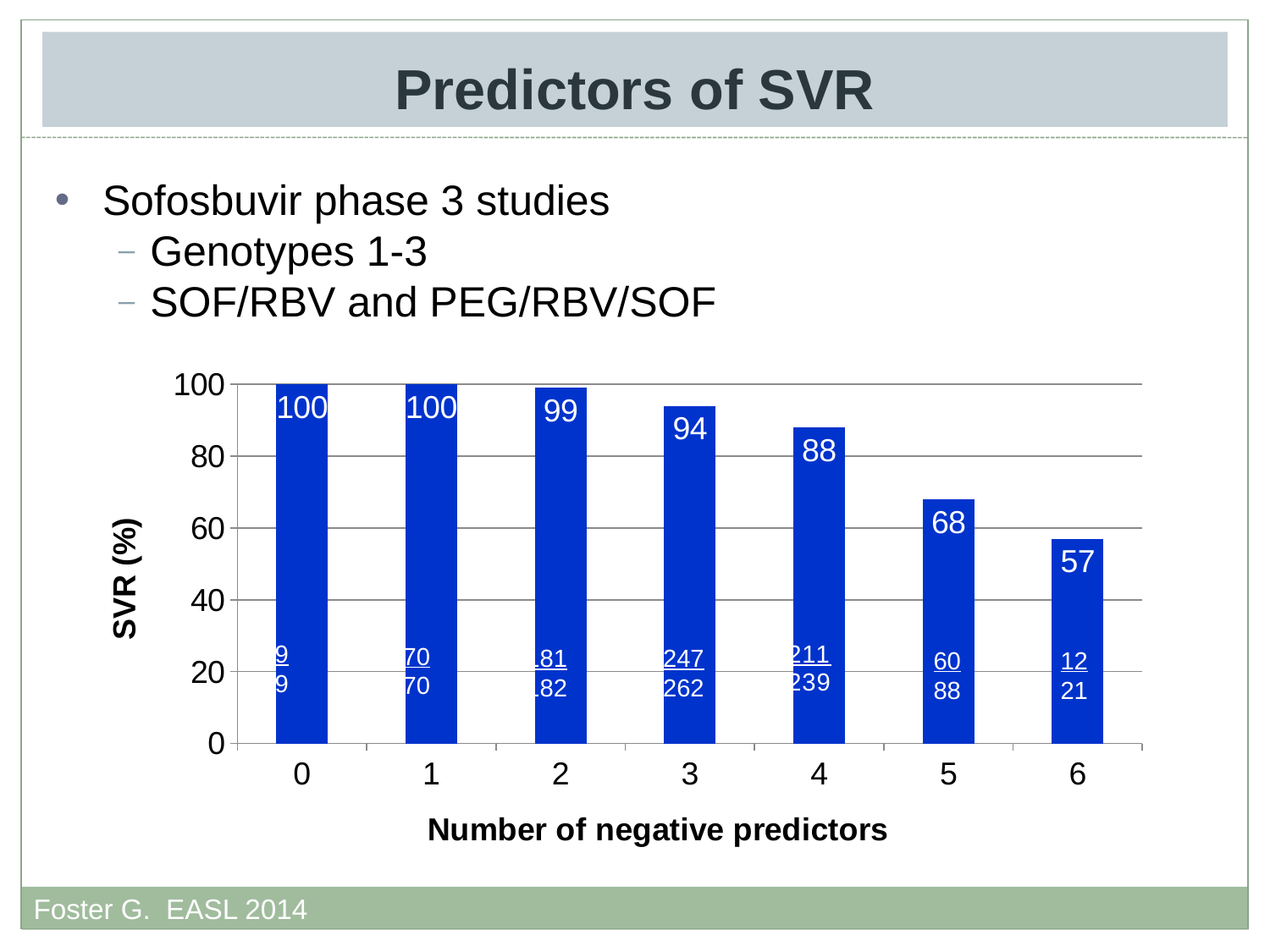
What kind of chart is shown on the slide? Bar chart What is the SVR (%) for 5 negative predictors? 68 Which number of negative predictors has the lowest SVR (%)? 6 What is the difference in SVR (%) between 4 and 6 negative predictors? 31 Does SVR (%) rise or fall as the number of negative predictors increases? Fall What is the label of the x axis of the chart? Number of negative predictors What is the SVR (%) for 6 negative predictors? 57 What is the SVR (%) for 4 negative predictors? 88 What is the SVR (%) for 3 negative predictors? 94 How many categories (numbers of negative predictors) are shown on the x axis? 7 Which has a higher SVR (%): 3 negative predictors or 5 negative predictors? 3 negative predictors What is the difference in SVR (%) between 2 and 5 negative predictors? 31